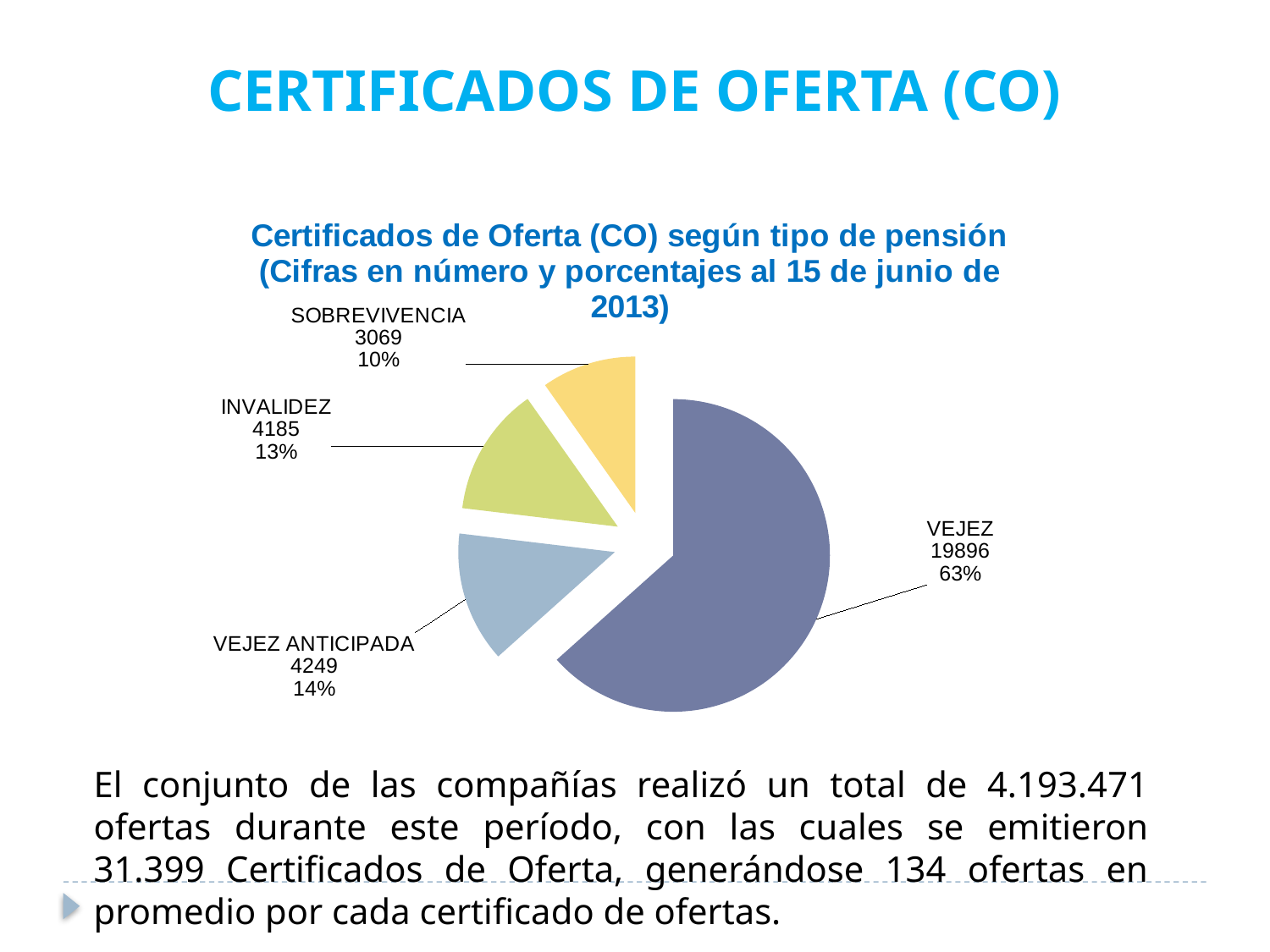
What kind of chart is shown on the slide? pie chart Which pension type has the smallest slice? SOBREVIVENCIA Which is larger, the value for INVALIDEZ or the value for SOBREVIVENCIA? INVALIDEZ What is the number of Certificados de Oferta for VEJEZ? 19896 How many slices does the pie chart have? 4 What percentage share does VEJEZ have in the pie chart? 63% What is the difference between the VEJEZ and VEJEZ ANTICIPADA values? 15647 What is the number of Certificados de Oferta for SOBREVIVENCIA? 3069 What is the number of Certificados de Oferta for INVALIDEZ? 4185 What is the title of the pie chart? Certificados de Oferta (CO) según tipo de pensión (Cifras en número y porcentajes al 15 de junio de 2013) Which pension type has the largest slice? VEJEZ What percentage share does VEJEZ ANTICIPADA have in the pie chart? 14%